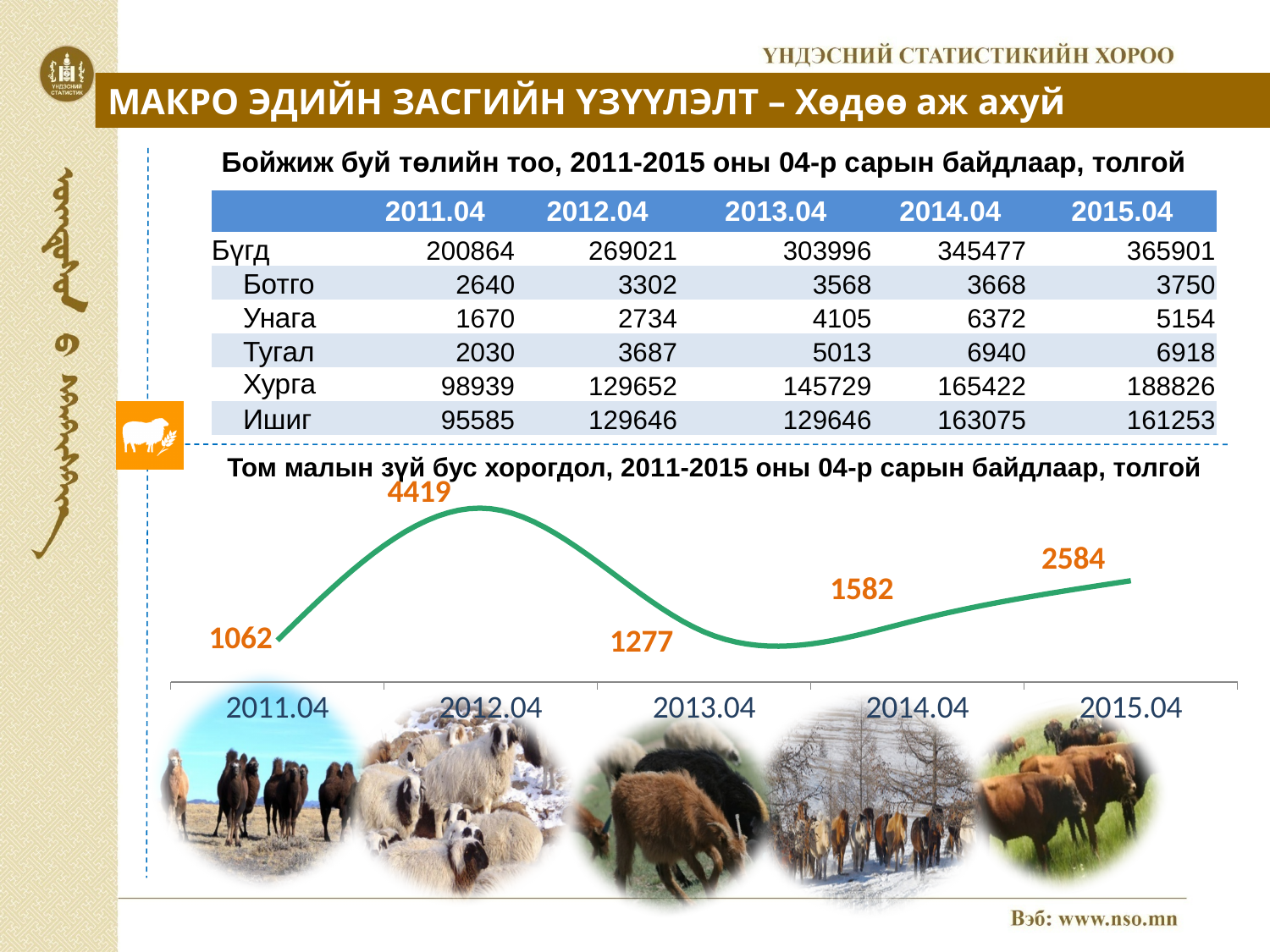
In the line chart 'Том малын зүй бус хорогдол', do the values rise or fall from 2013.04 to 2015.04? rise How many data points are plotted in the line chart 'Том малын зүй бус хорогдол'? 5 In the line chart 'Том малын зүй бус хорогдол', what is the value for 2015.04? 2584 What type of chart is shown at the bottom of the slide under the title 'Том малын зүй бус хорогдол'? line chart In the line chart 'Том малын зүй бус хорогдол', what is the value for 2012.04? 4419 In the line chart 'Том малын зүй бус хорогдол', what is the difference between the values for 2015.04 and 2014.04? 1002 In the line chart 'Том малын зүй бус хорогдол', what is the value for 2011.04? 1062 In the line chart 'Том малын зүй бус хорогдол', what is the difference between the values for 2012.04 and 2013.04? 3142 In the line chart 'Том малын зүй бус хорогдол', what is the value for 2013.04? 1277 In the line chart 'Том малын зүй бус хорогдол', which period has the lowest value? 2011.04 In the line chart 'Том малын зүй бус хорогдол', which period has the highest value? 2012.04 In the line chart 'Том малын зүй бус хорогдол', which is larger, the value for 2014.04 or the value for 2013.04? 2014.04